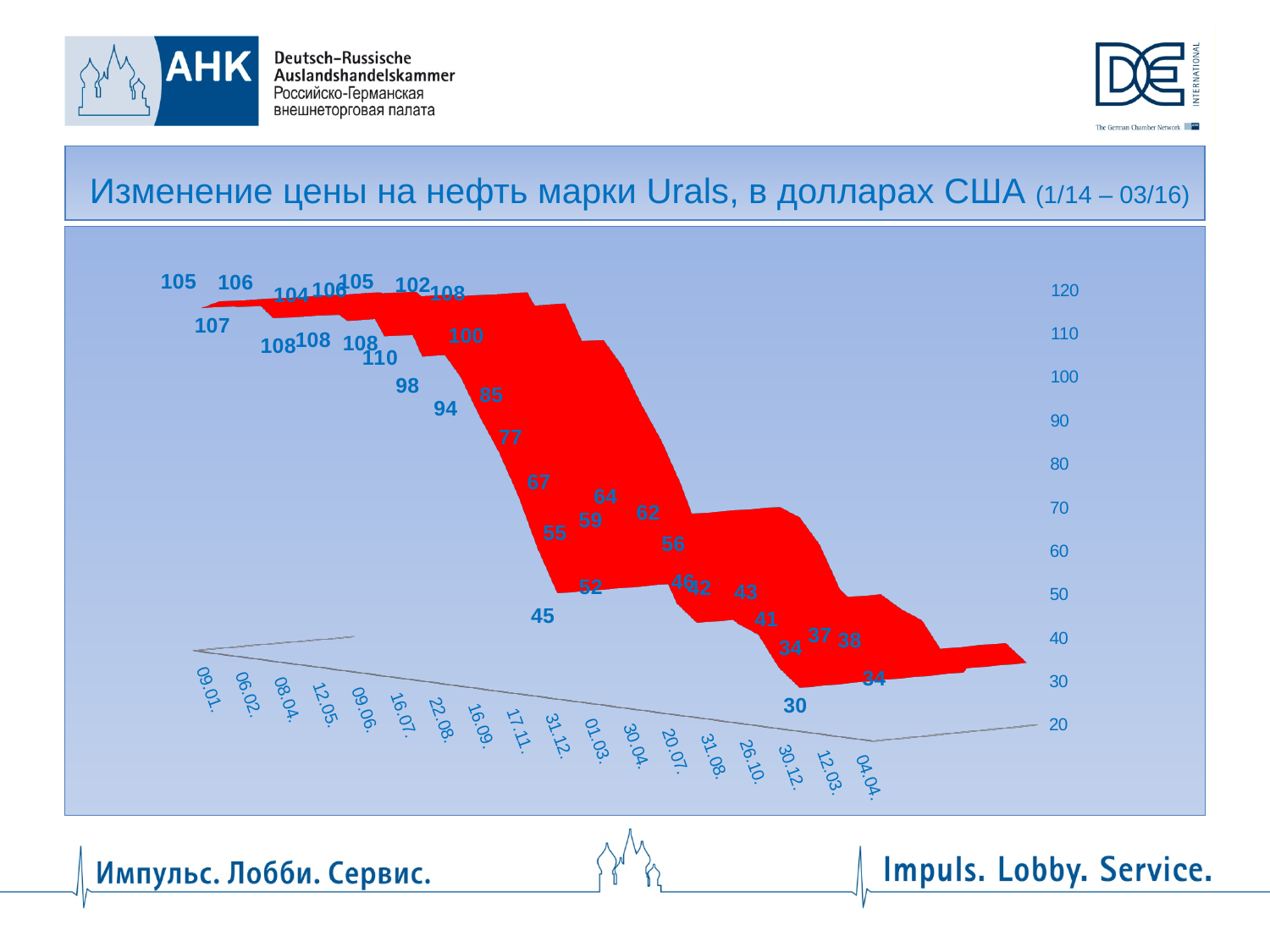
Do the values rise or fall along the x axis from 09.01 to 04.04? fall What is the highest value printed as a data label on the chart? 110 What is the first data label shown at the start of the series (09.01)? 105 Is the value at the last date (04.04) greater or less than 40? less What is the difference between the highest data label (110) and the lowest data label (30)? 80 Which is larger, the value at the start of the series (09.01) or the value at the end (04.04)? 09.01 Is the value at the first date (09.01) greater or less than 100? greater How many date labels are shown on the x axis? 18 What is the maximum value shown on the vertical axis? 120 What is the title of the chart? Изменение цены на нефть марки Urals, в долларах США (1/14 – 03/16) What kind of chart is shown on the slide? 3D line chart What is the lowest value printed as a data label on the chart? 30